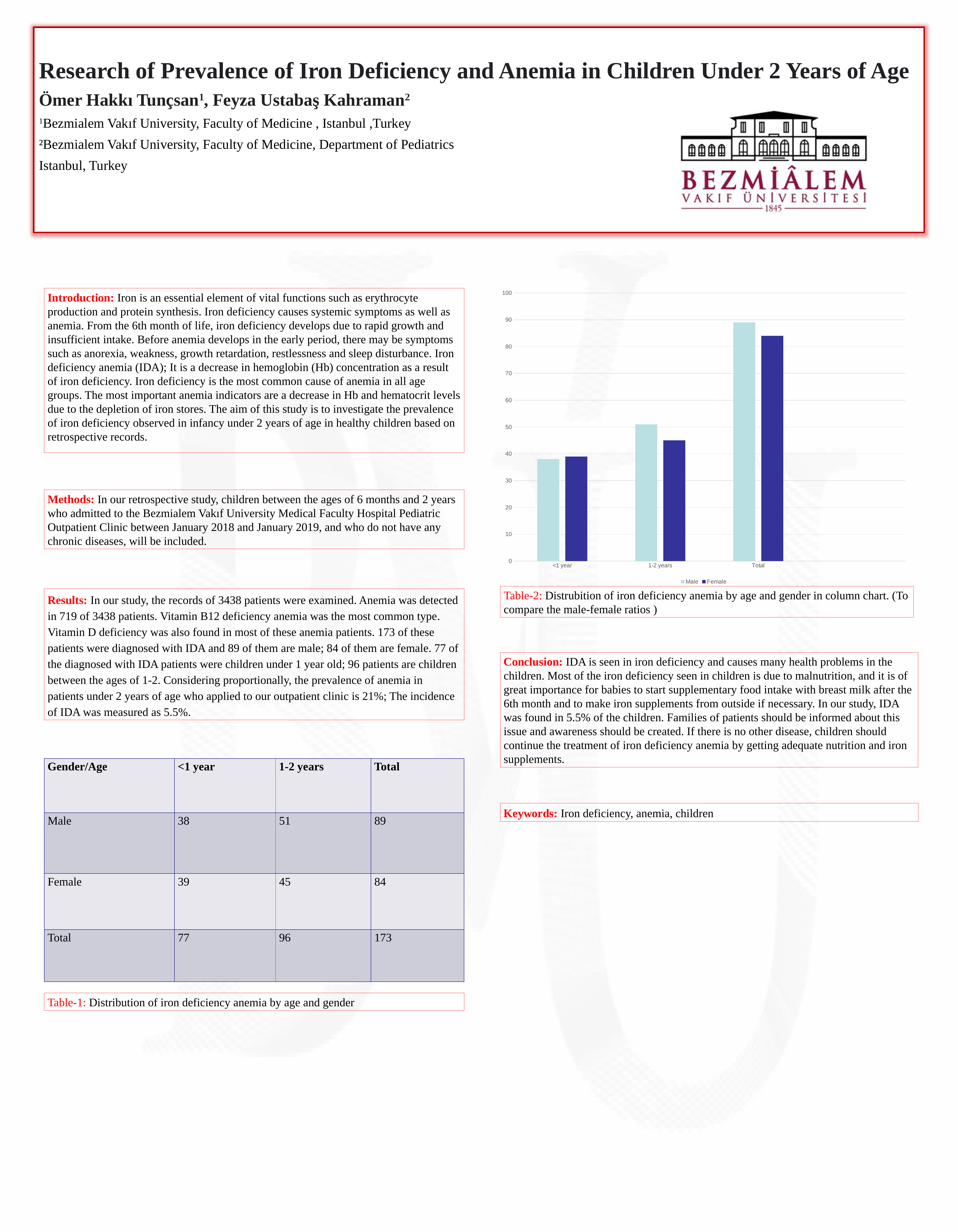
Is the Female value for 1-2 years greater or less than 50? less Which series is shown in dark blue in the chart legend? Female Is the Female value for Total greater or less than 80? greater In the 1-2 years category, which bar is taller, Male or Female? Male In the Total category, which bar is taller, Male or Female? Male Do the Male bars rise or fall from <1 year to Total along the x axis? rise Is the Male value for Total greater or less than 80? greater How many series does the chart legend list? 2 How many categories are shown on the x axis of the chart? 3 Which category has the tallest bar in the chart? Total What kind of chart is shown on the slide? bar chart